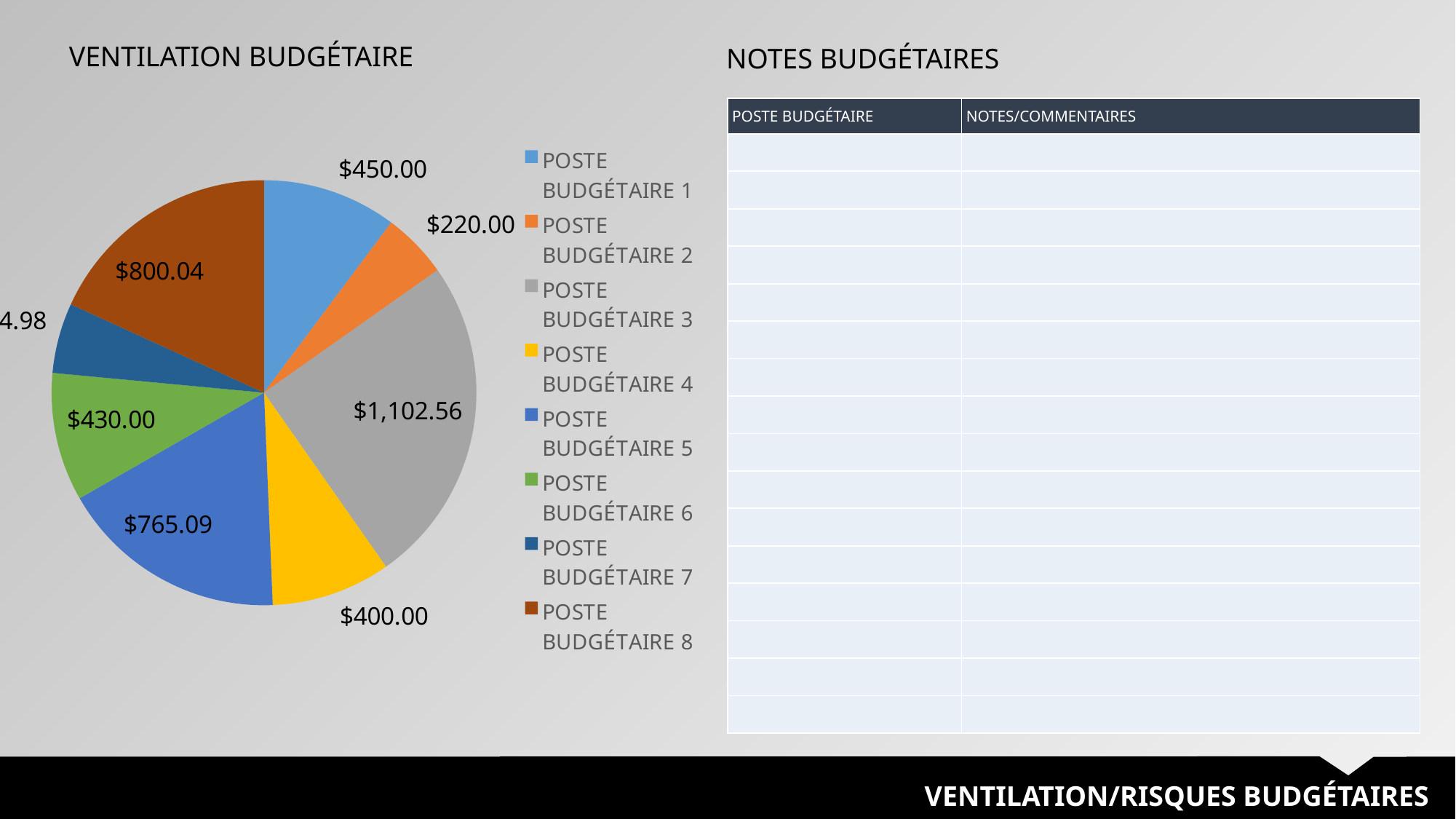
What is the value for POSTE BUDGÉTAIRE 3 in the pie chart? $1,102.56 What kind of chart is shown on the slide? Pie chart Which budget item has the largest slice in the pie chart? POSTE BUDGÉTAIRE 3 What is the value for POSTE BUDGÉTAIRE 5 in the pie chart? $765.09 What is the value for POSTE BUDGÉTAIRE 8 in the pie chart? $800.04 What is the value for POSTE BUDGÉTAIRE 1 in the pie chart? $450.00 What is the difference between the values for POSTE BUDGÉTAIRE 3 and POSTE BUDGÉTAIRE 2? $882.56 What is the title of the chart on the slide? VENTILATION BUDGÉTAIRE What is the difference between the values for POSTE BUDGÉTAIRE 1 and POSTE BUDGÉTAIRE 4? $50.00 How many budget items are shown in the pie chart? 8 What is the difference between the values for POSTE BUDGÉTAIRE 8 and POSTE BUDGÉTAIRE 5? $34.95 Which is larger, the value for POSTE BUDGÉTAIRE 6 or POSTE BUDGÉTAIRE 4? POSTE BUDGÉTAIRE 6